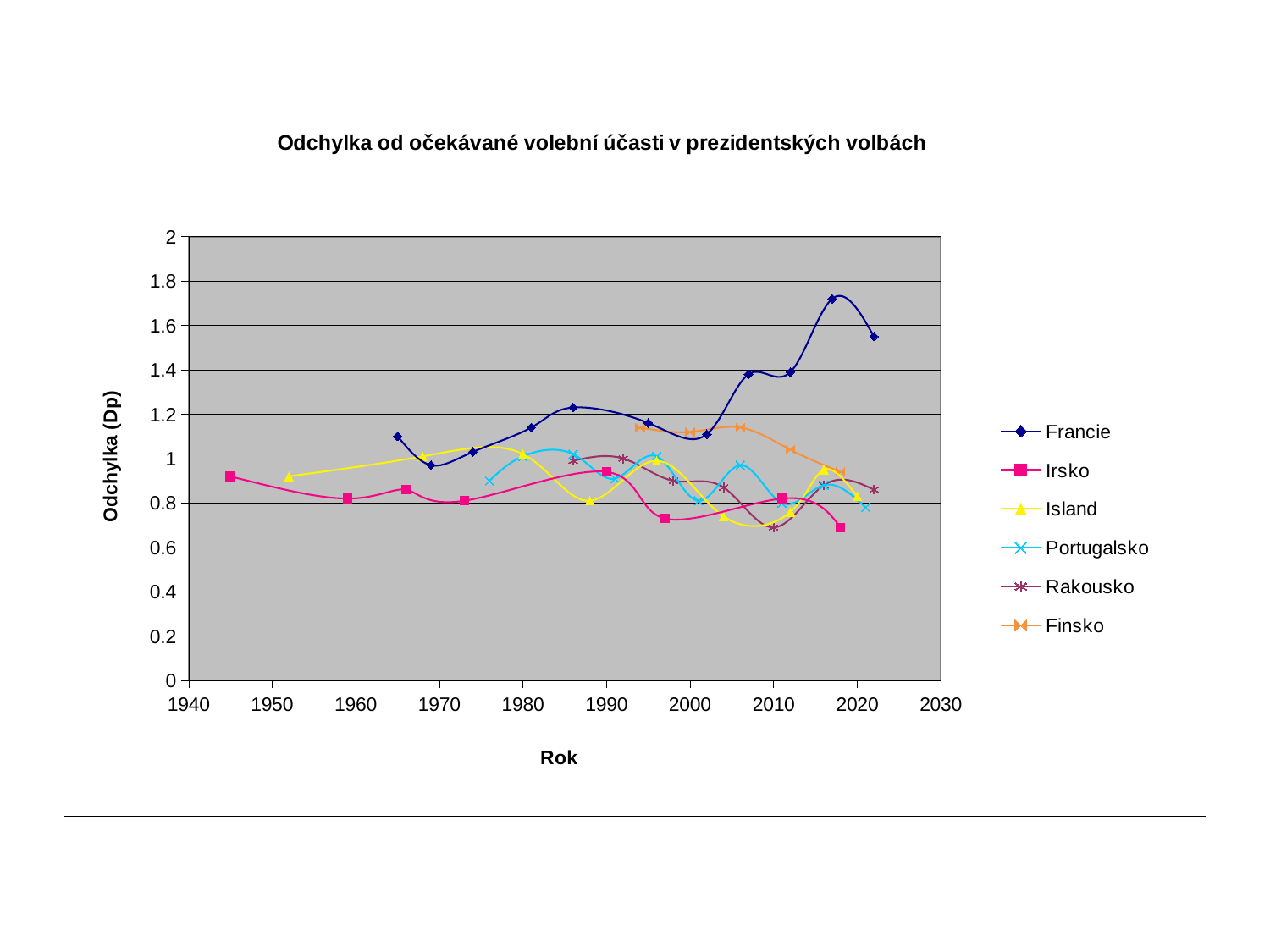
How many series does the legend list? 6 Which is larger: the value for Francie around 2022 or the value for Finsko around 2018? Francie around 2022 Is the last value for Irsko (around 2018) greater or less than 0.8? less What is the title of the chart? Odchylka od očekávané volební účasti v prezidentských volbách Is the value for Francie around 2007 greater or less than 1.2? greater Is the highest value for Francie (around 2017) greater or less than 1.6? greater Which series reaches the highest value on the chart? Francie What is the label of the x axis? Rok Do the values for Francie rise or fall between 2002 and 2017? rise What kind of chart is shown on the slide? line chart